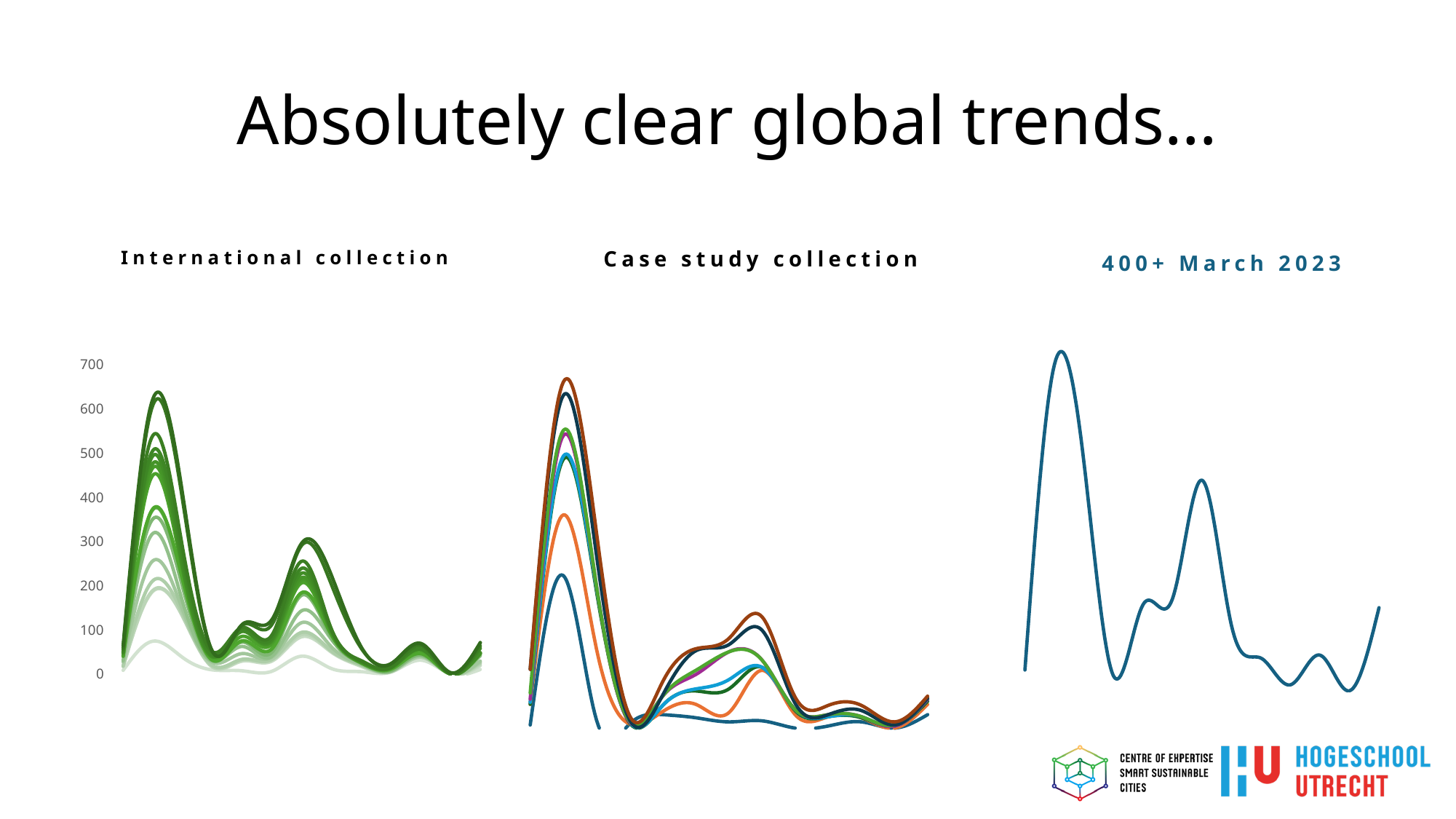
How many charts are shown on the slide? 3 In the '400+ March 2023' chart, does the line end higher or lower than its first peak? lower What is the title of the rightmost chart on the slide? 400+ March 2023 What kind of chart is the 'International collection' chart? line chart In the 'International collection' chart, is the highest peak of the darkest green line greater or less than 600? greater In the '400+ March 2023' chart, is the second peak higher or lower than the first peak? lower What kind of chart is the '400+ March 2023' chart? line chart How many lines are plotted in the '400+ March 2023' chart? 1 In the 'International collection' chart, is the first peak of the lightest green line greater or less than 200? less In the 'International collection' chart, is the second peak of the darkest green line greater or less than 400? less In the 'International collection' chart, what is the highest value shown on the y axis? 700